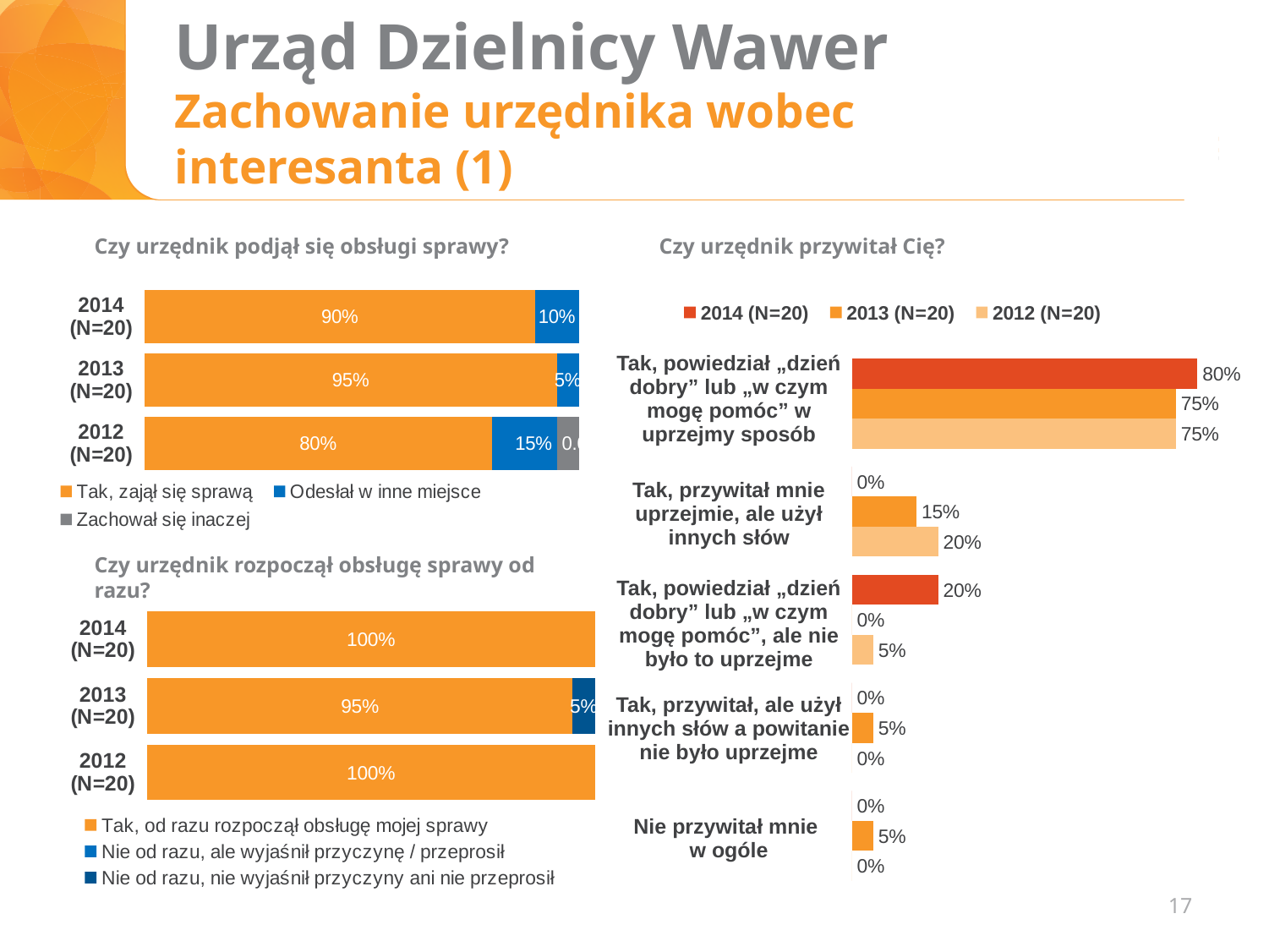
In the chart "Czy urzędnik podjął się obsługi sprawy?", which year has the highest share of "Tak, zajął się sprawą"? 2013 (N=20) In the chart "Czy urzędnik przywitał Cię?", which is larger for "Tak, powiedział „dzień dobry” lub „w czym mogę pomóc”, ale nie było to uprzejme": the 2014 (N=20) value or the 2012 (N=20) value? 2014 (N=20) In the chart "Czy urzędnik przywitał Cię?", how many categories are shown on the vertical axis? 5 In the chart "Czy urzędnik przywitał Cię?", what is the 2012 (N=20) value for "Tak, przywitał mnie uprzejmie, ale użył innych słów"? 20% In the chart "Czy urzędnik rozpoczął obsługę sprawy od razu?", what is the difference between the 2014 (N=20) and 2013 (N=20) values for "Tak, od razu rozpoczął obsługę mojej sprawy"? 5% What type of chart is "Czy urzędnik przywitał Cię?"? Bar chart In the chart "Czy urzędnik przywitał Cię?", what is the difference between the 2014 (N=20) and 2013 (N=20) values for "Tak, powiedział „dzień dobry” lub „w czym mogę pomóc” w uprzejmy sposób"? 5% In the chart "Czy urzędnik podjął się obsługi sprawy?", what percentage for 2014 (N=20) is shown for "Tak, zajął się sprawą"? 90% In the chart "Czy urzędnik podjął się obsługi sprawy?", how many entries does the legend list? 3 In the chart "Czy urzędnik podjął się obsługi sprawy?", what is the value of "Odesłał w inne miejsce" for 2012 (N=20)? 15% In the chart "Czy urzędnik przywitał Cię?", what is the 2014 (N=20) value for "Tak, powiedział „dzień dobry” lub „w czym mogę pomóc” w uprzejmy sposób"? 80% In the chart "Czy urzędnik rozpoczął obsługę sprawy od razu?", what is the value of "Tak, od razu rozpoczął obsługę mojej sprawy" for 2013 (N=20)? 95%